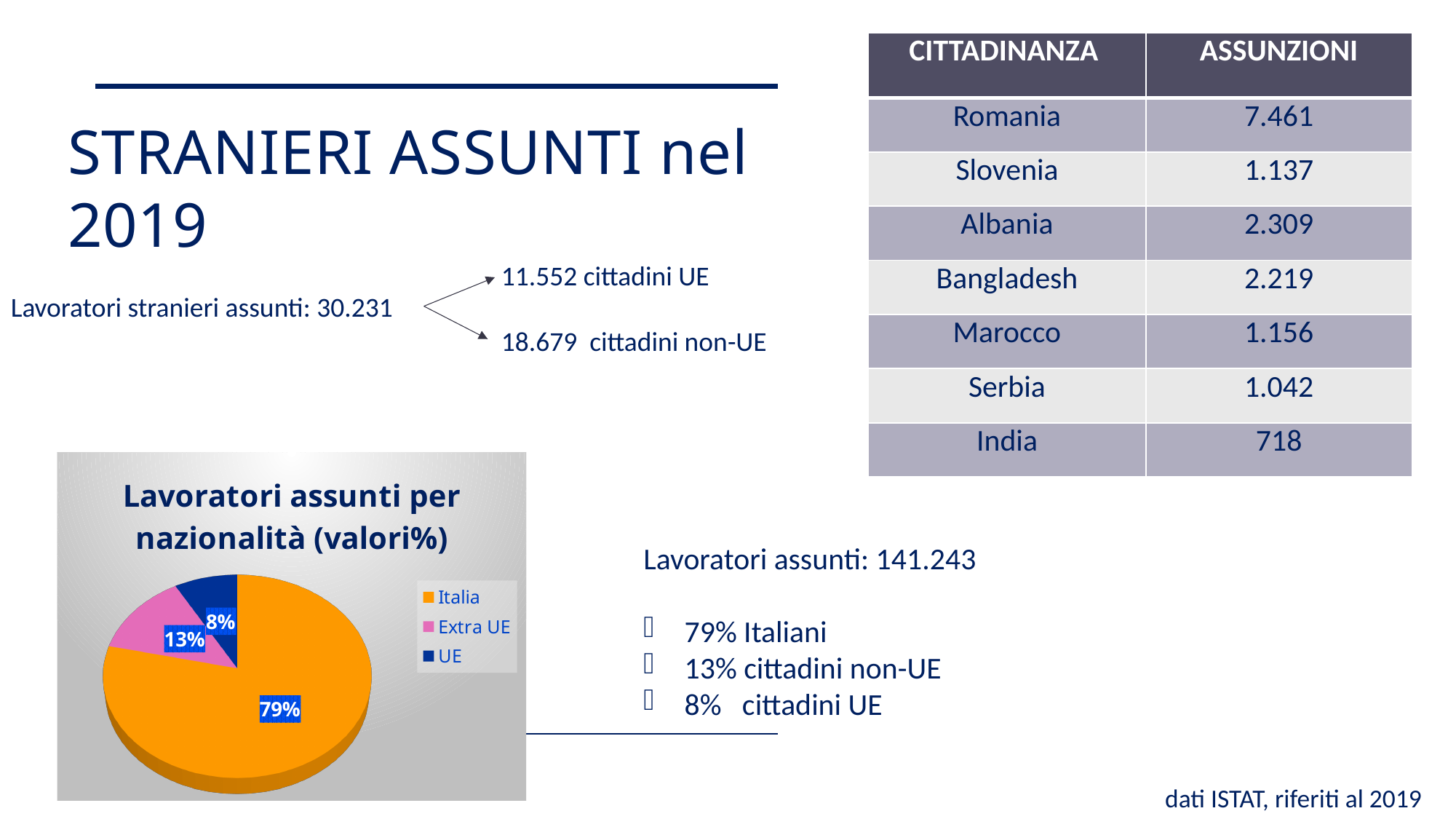
What share of the pie chart does Extra UE have? 13% What is the title of the pie chart? Lavoratori assunti per nazionalità (valori%) What share of the pie chart does Italia have? 79% What share of the pie chart does UE have? 8% How many slices does the pie chart have? 3 Which legend entry in the pie chart is shown in orange? Italia Which category has the largest slice in the pie chart? Italia What is the difference in percentage points between the Italia slice and the Extra UE slice? 66 Which slice is larger in the pie chart, Extra UE or UE? Extra UE What is the difference in percentage points between the Extra UE slice and the UE slice? 5 Which category has the smallest slice in the pie chart? UE What kind of chart is shown on the slide? pie chart